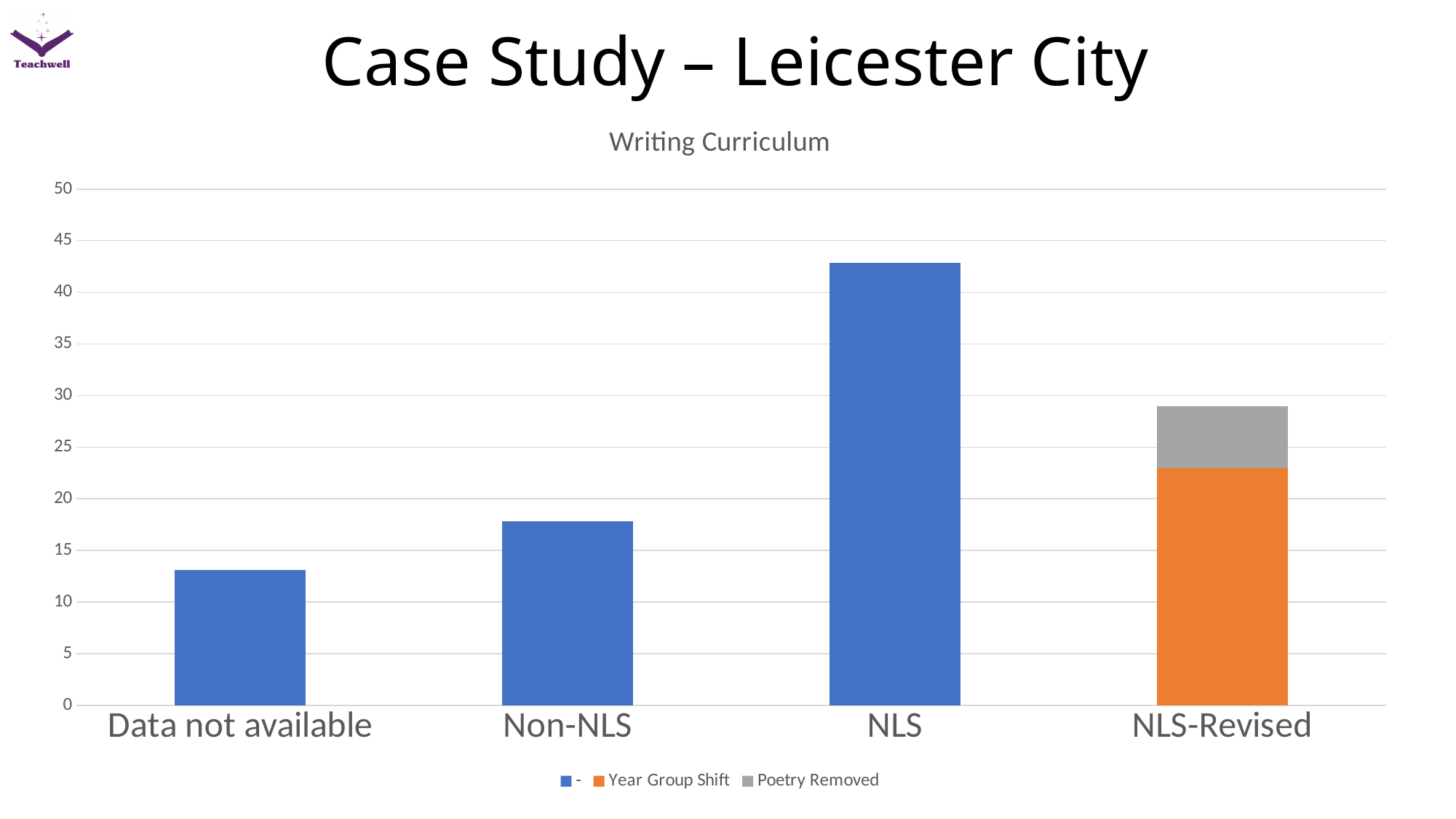
Which is larger, the bar for Non-NLS or the bar for NLS-Revised? NLS-Revised How many categories are shown on the x axis of the chart? 4 What is the title of the chart? Writing Curriculum Is the total height of the NLS-Revised bar greater or less than 25? greater Which category has the shortest bar in the chart? Data not available Is the bar for NLS greater or less than 40? greater Which legend entry is shown in grey? Poetry Removed What kind of chart is shown on the slide? Bar chart Is the bar for Data not available greater or less than 15? less Which category has the tallest bar in the chart? NLS How many series does the chart's legend list? 3